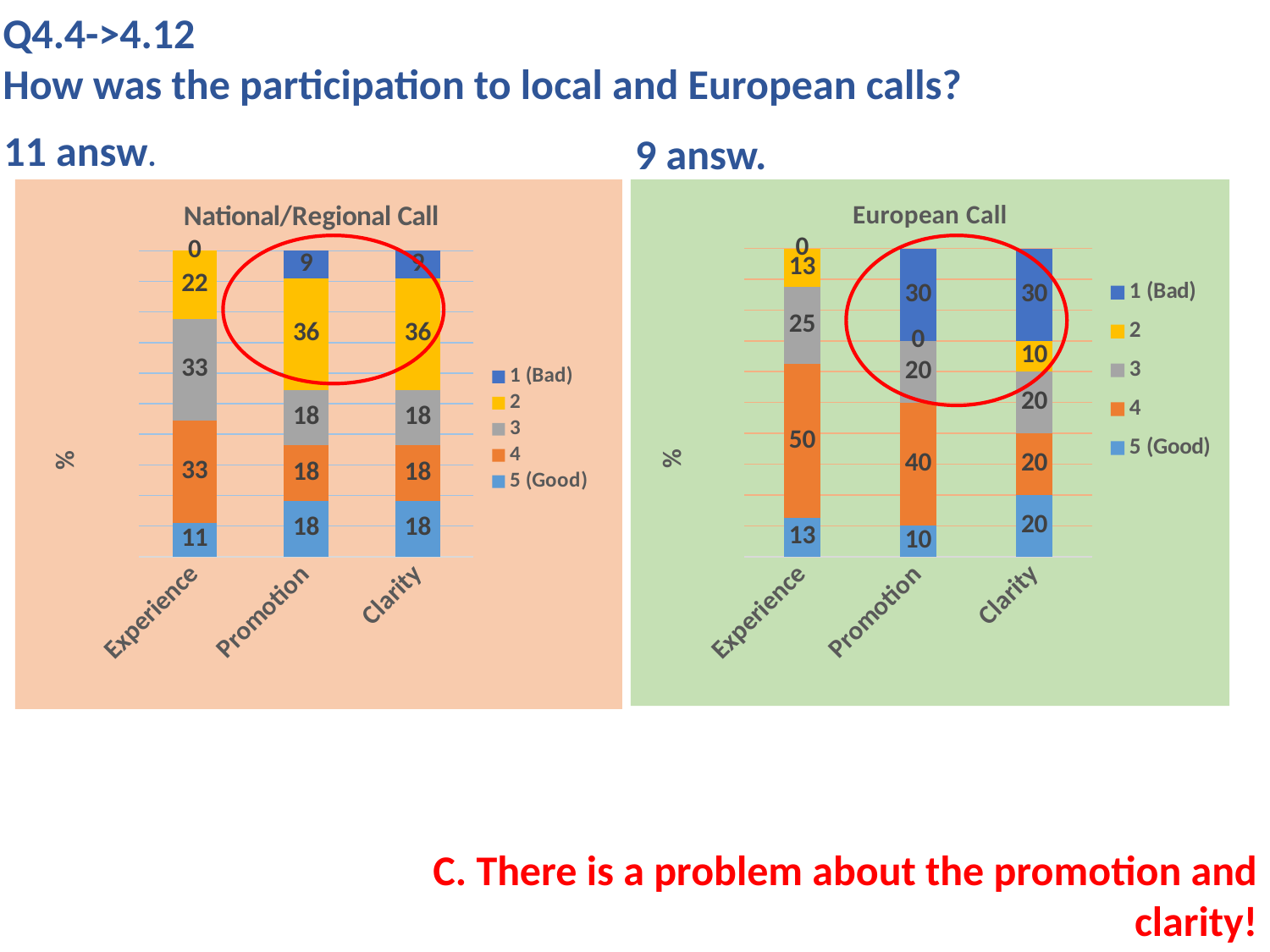
What type of chart is the National/Regional Call chart? Stacked bar chart In the European Call chart, what is the value of the 1 (Bad) series for Promotion? 30 In the European Call chart, which is larger: the 3 series value for Experience or for Clarity? Experience How many series does the legend of the European Call chart list? 5 In the European Call chart, which category has the lowest value for the 5 (Good) series? Promotion How many categories are shown on the x axis of the National/Regional Call chart? 3 In the National/Regional Call chart, what is the difference between the 2 series values for Promotion and Experience? 14 In the European Call chart, what is the total of the stacked bar for Promotion? 100 In the European Call chart, what is the value of the 4 series for Experience? 50 In the National/Regional Call chart, what is the value of the 5 (Good) series for Experience? 11 In the National/Regional Call chart, what is the value of the 2 series for Promotion? 36 In the European Call chart, which category has the highest value for the 4 series? Experience